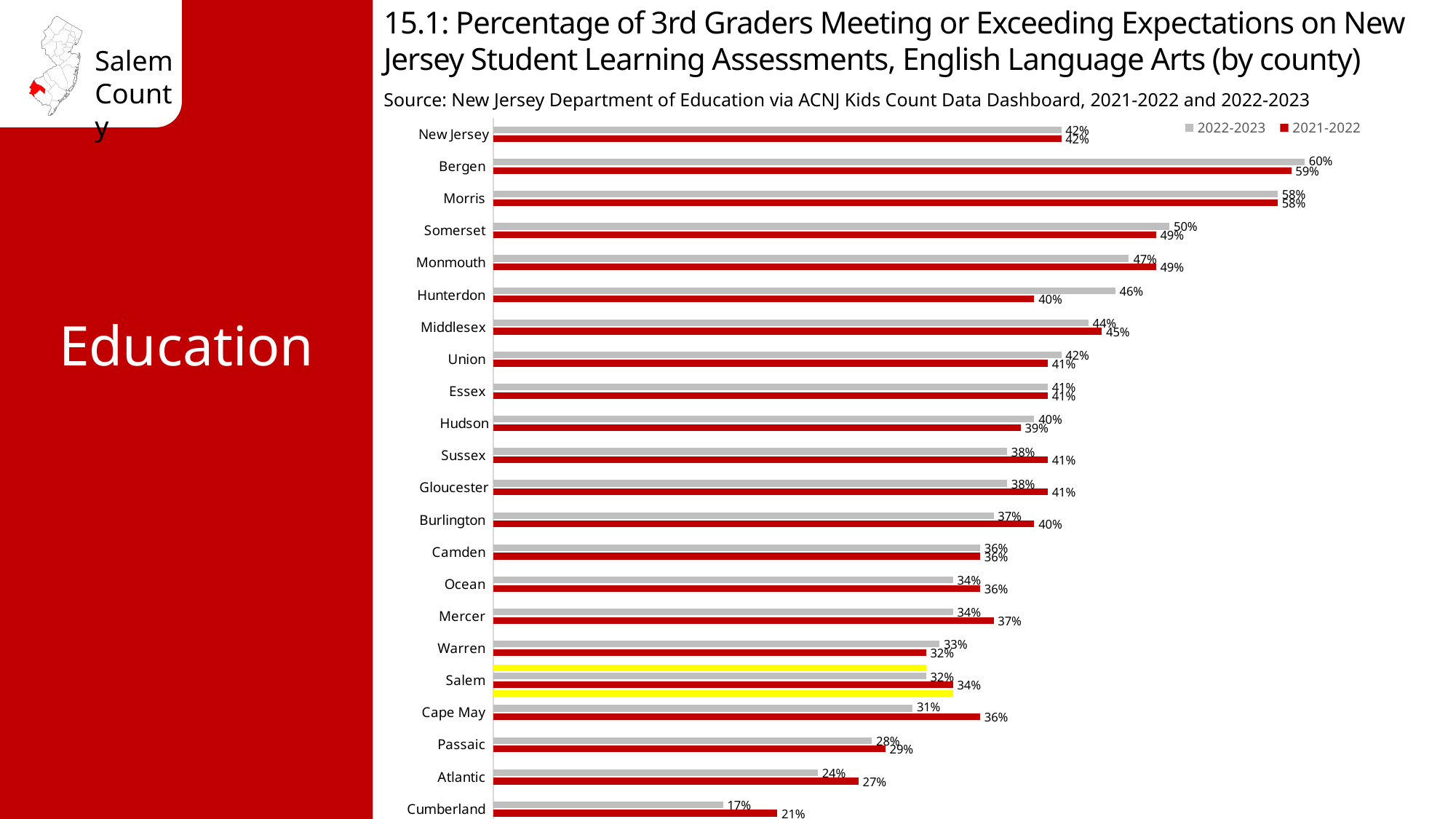
What kind of chart is shown on the slide? Bar chart Which county has the lowest 2021-2022 value? Cumberland Which county has the highest 2022-2023 value? Bergen What is the 2021-2022 value for Salem? 34% What is the difference between the 2021-2022 and 2022-2023 values for Hunterdon? 6% Which is larger for Cape May: the 2022-2023 value or the 2021-2022 value? 2021-2022 How many categories (counties plus New Jersey) are shown on the chart? 22 Which series is shown in red in the legend? 2021-2022 What is the 2022-2023 value for Salem? 32% What is the 2022-2023 value for Hunterdon? 46% How many series does the legend list? 2 What is the 2022-2023 value for New Jersey overall? 42%